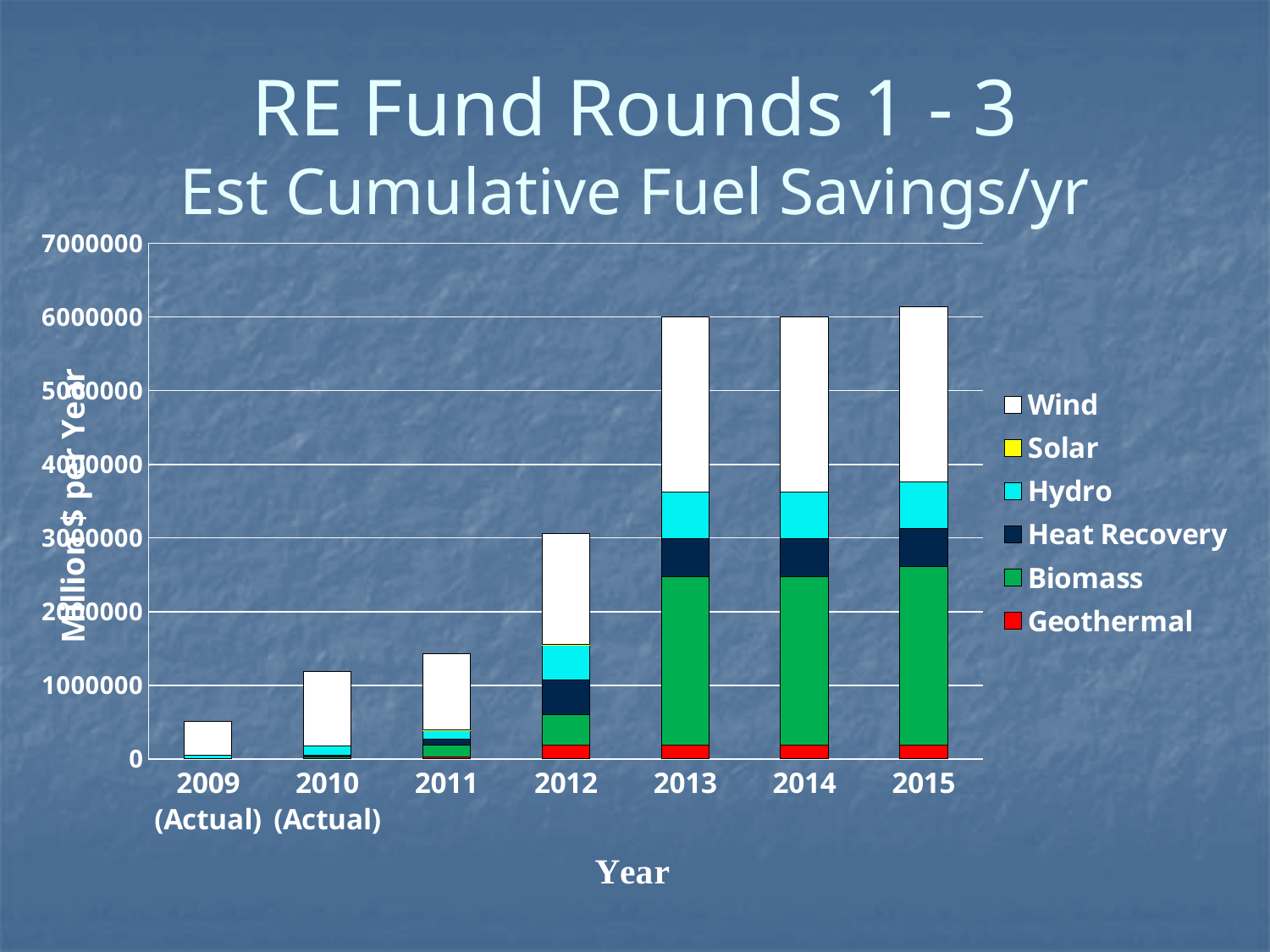
Do the total fuel savings generally rise or fall from 2009 to 2015? Rise Which year has the tallest stacked bar in the chart? 2015 How many years are shown along the x axis of the chart? 7 Is the total value for 2009 (Actual) greater or less than 1000000? less Which year has the shortest stacked bar in the chart? 2009 (Actual) Which year has the larger total bar, 2011 or 2012? 2012 Which series is shown in white at the top of each stacked bar? Wind How many series does the chart's legend list? 6 What kind of chart is shown on the slide? Stacked bar chart Is the total value for 2011 greater or less than 2000000? less Is the total value for 2013 greater or less than 5000000? greater